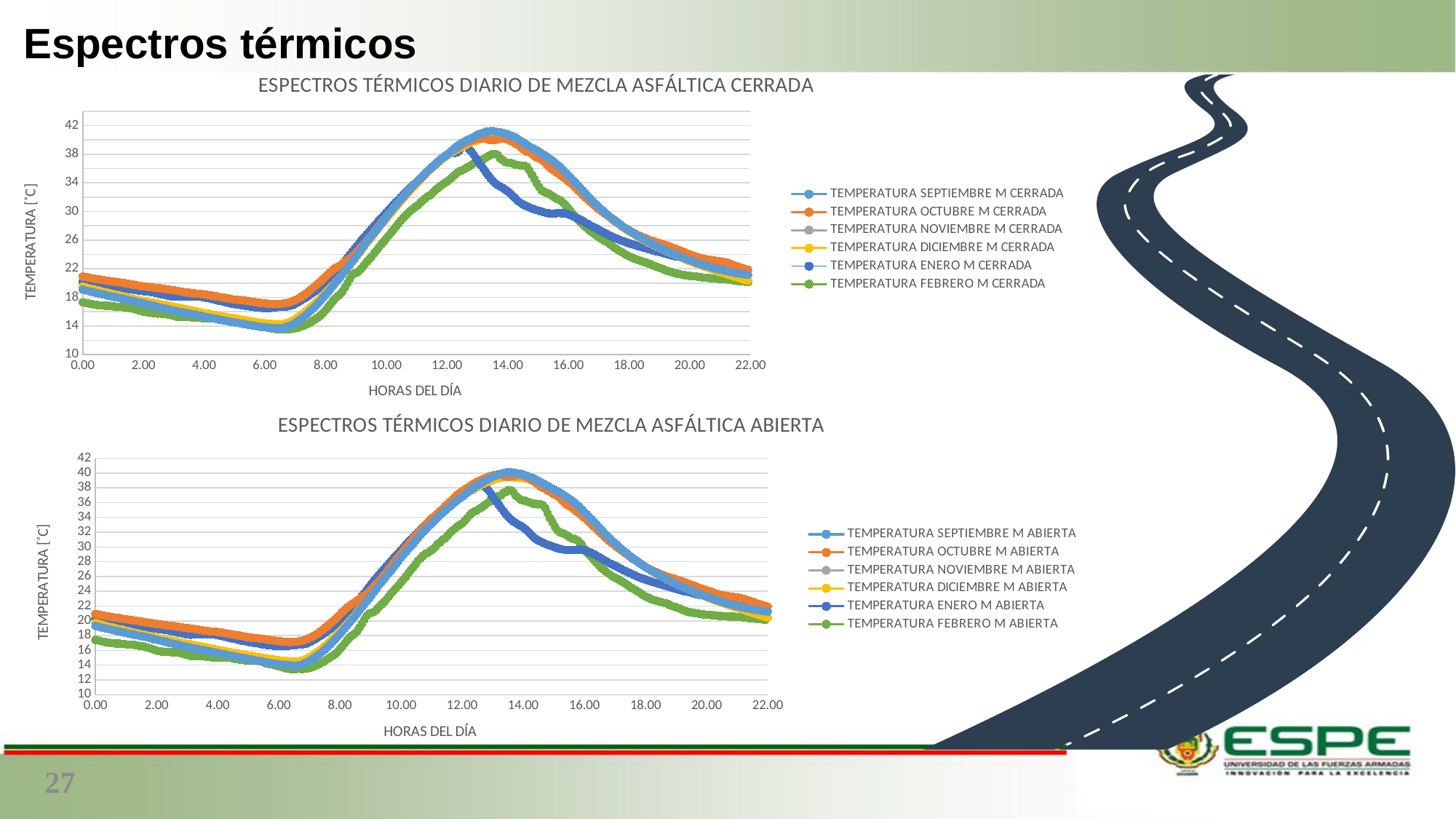
How many series does the legend of the bottom chart (MEZCLA ASFÁLTICA ABIERTA) list? 6 In the bottom chart (MEZCLA ASFÁLTICA ABIERTA), is the value of TEMPERATURA FEBRERO M ABIERTA at 0.00 greater or less than 20? less In the bottom chart (MEZCLA ASFÁLTICA ABIERTA), which series reaches a higher peak: TEMPERATURA SEPTIEMBRE M ABIERTA or TEMPERATURA FEBRERO M ABIERTA? TEMPERATURA SEPTIEMBRE M ABIERTA In the top chart (MEZCLA ASFÁLTICA CERRADA), does TEMPERATURA SEPTIEMBRE M CERRADA rise or fall between 0.00 and 6.00 hours? fall In the bottom chart (MEZCLA ASFÁLTICA ABIERTA), is the peak value of TEMPERATURA SEPTIEMBRE M ABIERTA greater or less than 36? greater What is the title of the bottom chart on the slide? ESPECTROS TÉRMICOS DIARIO DE MEZCLA ASFÁLTICA ABIERTA In the top chart (MEZCLA ASFÁLTICA CERRADA), is the peak value of TEMPERATURA FEBRERO M CERRADA greater or less than 34? greater How many series does the legend of the top chart (MEZCLA ASFÁLTICA CERRADA) list? 6 In the top chart (MEZCLA ASFÁLTICA CERRADA), at 0.00 hours, which is higher: TEMPERATURA OCTUBRE M CERRADA or TEMPERATURA FEBRERO M CERRADA? TEMPERATURA OCTUBRE M CERRADA What is the x-axis label of the top chart (MEZCLA ASFÁLTICA CERRADA)? HORAS DEL DÍA What kind of chart is the top chart, 'ESPECTROS TÉRMICOS DIARIO DE MEZCLA ASFÁLTICA CERRADA'? Line chart